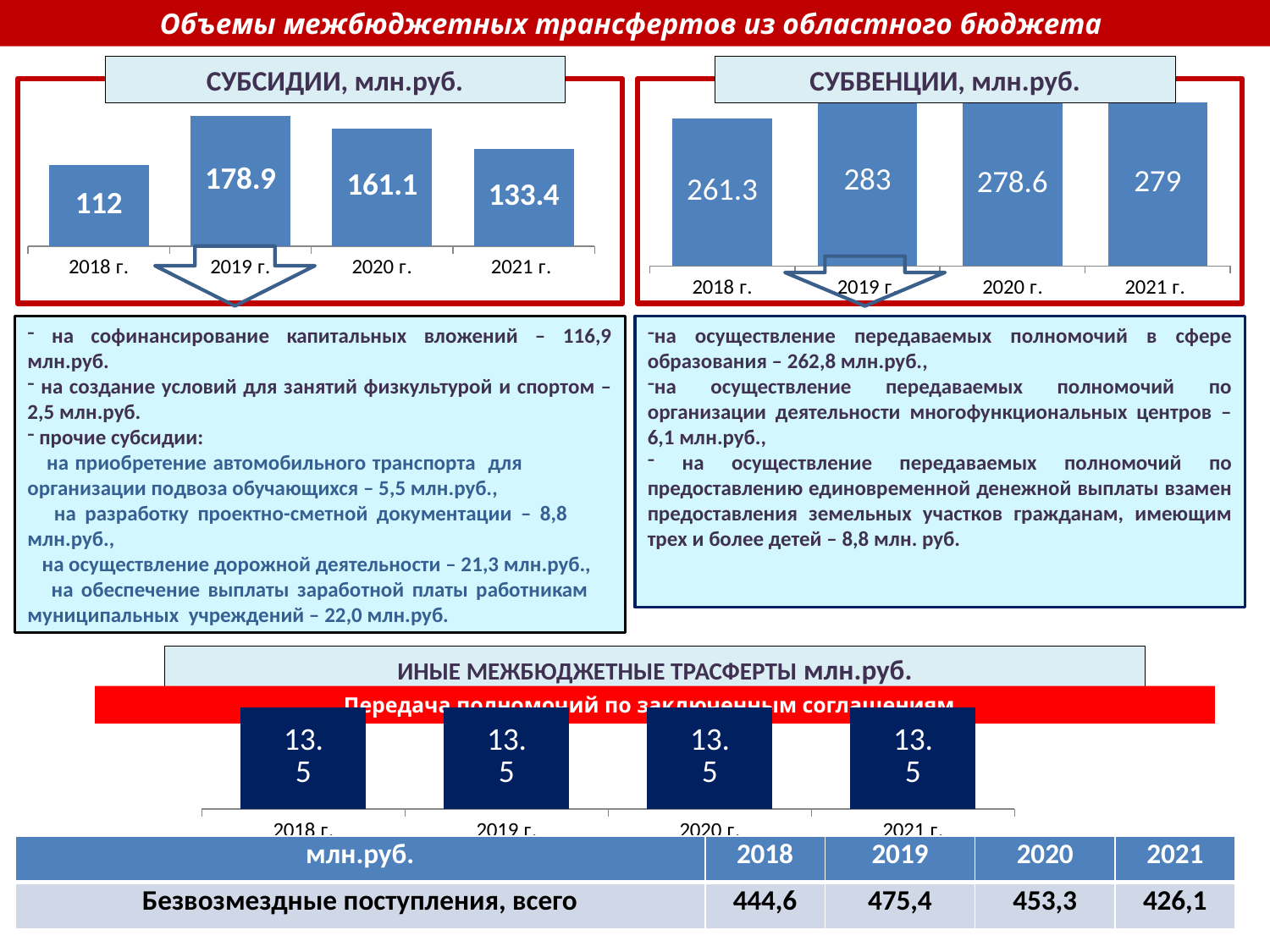
In the chart titled "СУБВЕНЦИИ, млн.руб.", is the value for 2018 г. larger or smaller than the value for 2021 г.? smaller What type of chart is the one titled "СУБСИДИИ, млн.руб."? bar chart In the chart titled "СУБВЕНЦИИ, млн.руб.", which year has the lowest value? 2018 г. In the chart titled "СУБВЕНЦИИ, млн.руб.", what is the difference between the values for 2019 г. and 2018 г.? 21.7 In the chart titled "СУБВЕНЦИИ, млн.руб.", what is the value for 2020 г.? 278.6 In the chart titled "СУБСИДИИ, млн.руб.", which year has the lowest value? 2018 г. In the chart titled "ИНЫЕ МЕЖБЮДЖЕТНЫЕ ТРАСФЕРТЫ млн.руб.", what is the value for 2020 г.? 13.5 In the chart titled "СУБСИДИИ, млн.руб.", what is the value for 2019 г.? 178.9 How many bars are in the chart titled "ИНЫЕ МЕЖБЮДЖЕТНЫЕ ТРАСФЕРТЫ млн.руб."? 4 In the chart titled "СУБСИДИИ, млн.руб.", what is the difference between the values for 2019 г. and 2021 г.? 45.5 In the chart titled "СУБСИДИИ, млн.руб.", do the values rise or fall from 2019 г. to 2021 г.? fall In the chart titled "СУБСИДИИ, млн.руб.", which year has the highest value? 2019 г.